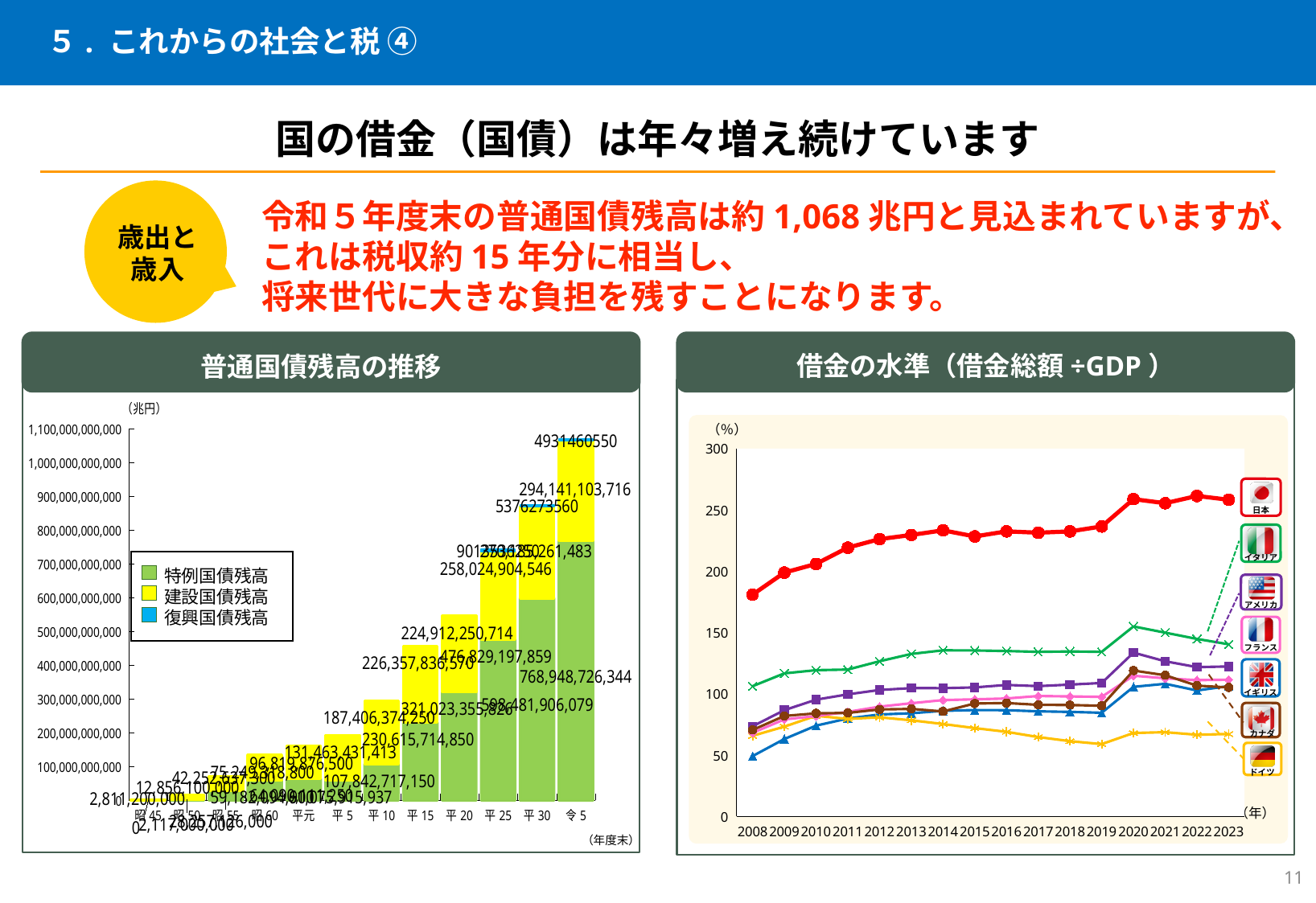
In the left chart 普通国債残高の推移, is the total bar for 令5 greater or less than 1,000,000,000,000? greater What kind of chart is the left chart titled 普通国債残高の推移? Stacked bar chart In the right chart 借金の水準（借金総額÷GDP）, how many countries are plotted? 7 In the right chart 借金の水準（借金総額÷GDP）, is the value for 日本 in 2023 greater or less than 250? greater In the left chart 普通国債残高の推移, how many year-end categories are shown on the x axis? 12 In the left chart 普通国債残高の推移, is the total bar for 平30 greater or less than 1,000,000,000,000? less In the left chart 普通国債残高の推移, which year-end has the tallest bar? 令5 What kind of chart is the right chart titled 借金の水準（借金総額÷GDP）? Line chart In the left chart 普通国債残高の推移, how many series does the legend list? 3 In the right chart 借金の水準（借金総額÷GDP）, which country has the highest value in 2023? 日本 In the right chart 借金の水準（借金総額÷GDP）, which is larger in 2023, 日本 or イタリア? 日本 In the left chart 普通国債残高の推移, do the bar totals rise or fall from 昭45 to 令5? Rise